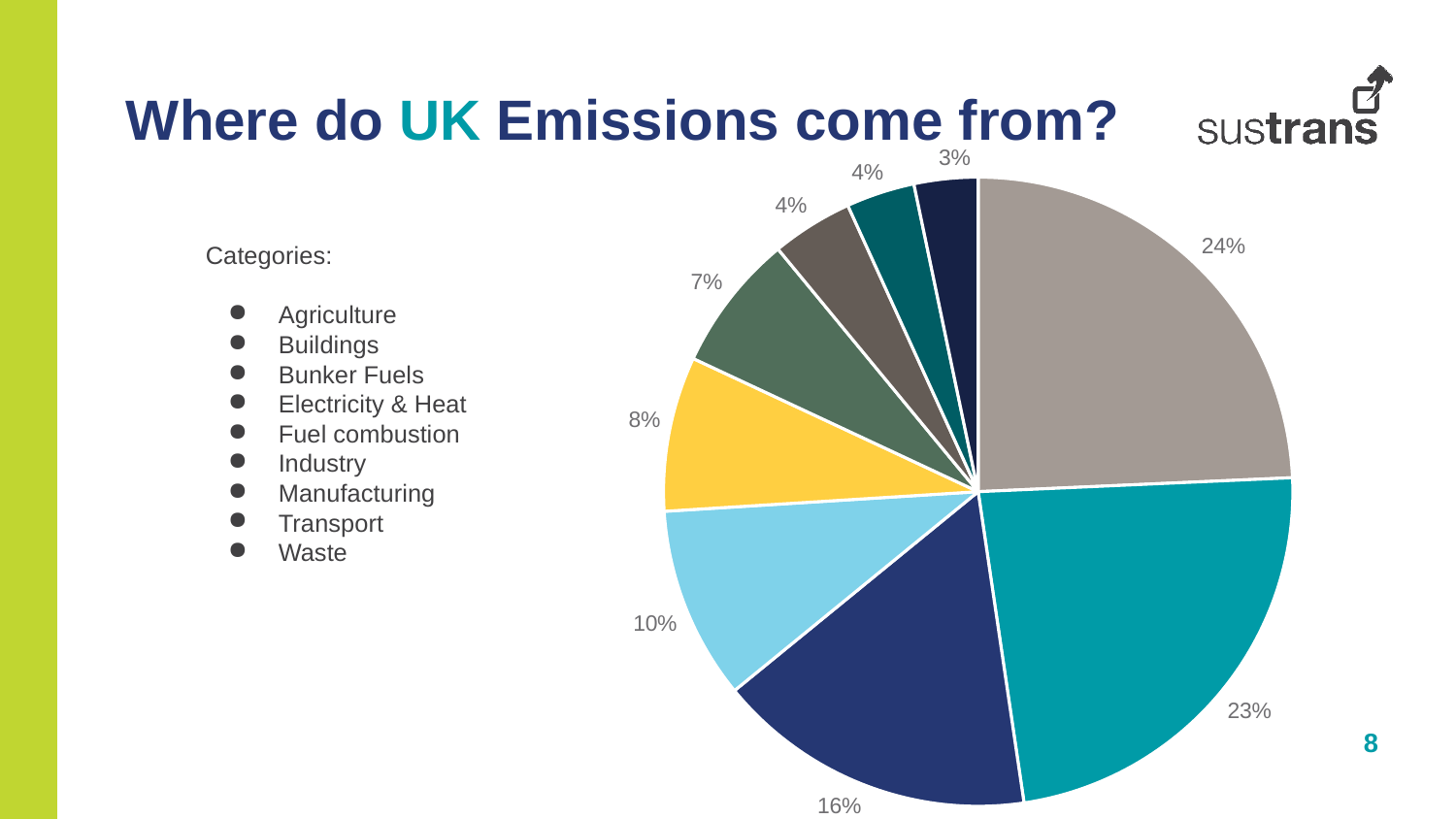
Which slice is larger, the grey slice labelled 24% or the teal slice labelled 23%? the grey slice (24%) What is the percentage of the smallest slice in the pie chart? 3% What is the combined share of the two largest slices (24% and 23%)? 47% How many slices of the pie chart are labelled 4%? 2 What percentage is shown for the light blue slice of the pie chart? 10% What is the difference in percentage points between the 16% slice and the 10% slice? 6 What percentage is shown for the yellow slice of the pie chart? 8% What is the title of the slide containing the pie chart? Where do UK Emissions come from? What kind of chart is shown on the slide? pie chart How many slices does the pie chart have? 9 What is the difference in percentage points between the largest slice (24%) and the second largest slice (23%)? 1 What is the percentage of the largest slice in the pie chart? 24%